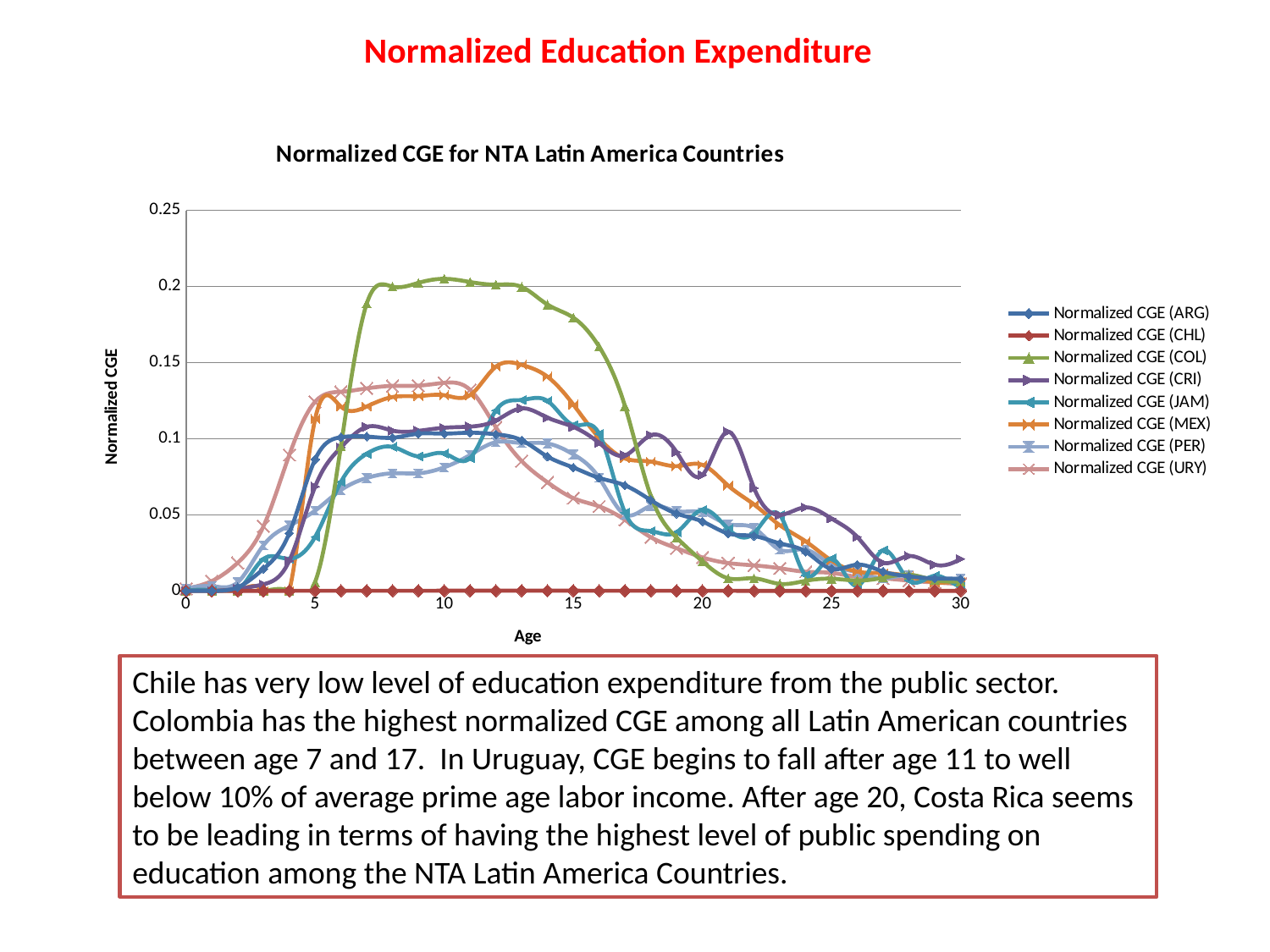
At age 20, which is larger: Normalized CGE (CRI) or Normalized CGE (COL)? Normalized CGE (CRI) Is the value for Normalized CGE (MEX) at age 12 greater or less than 0.1? greater Does the Normalized CGE (COL) series rise or fall between age 10 and age 20? fall Is the value for Normalized CGE (COL) at age 10 greater or less than 0.15? greater Which series has the lowest value at age 15? Normalized CGE (CHL) How many series does the legend list? 8 What kind of chart is shown on the slide? Line chart What is the label of the x axis? Age Which series has the highest value at age 10? Normalized CGE (COL) What is the title of the chart? Normalized CGE for NTA Latin America Countries Does the Normalized CGE (URY) series rise or fall between age 0 and age 8? rise Is the value for Normalized CGE (URY) at age 25 greater or less than 0.05? less